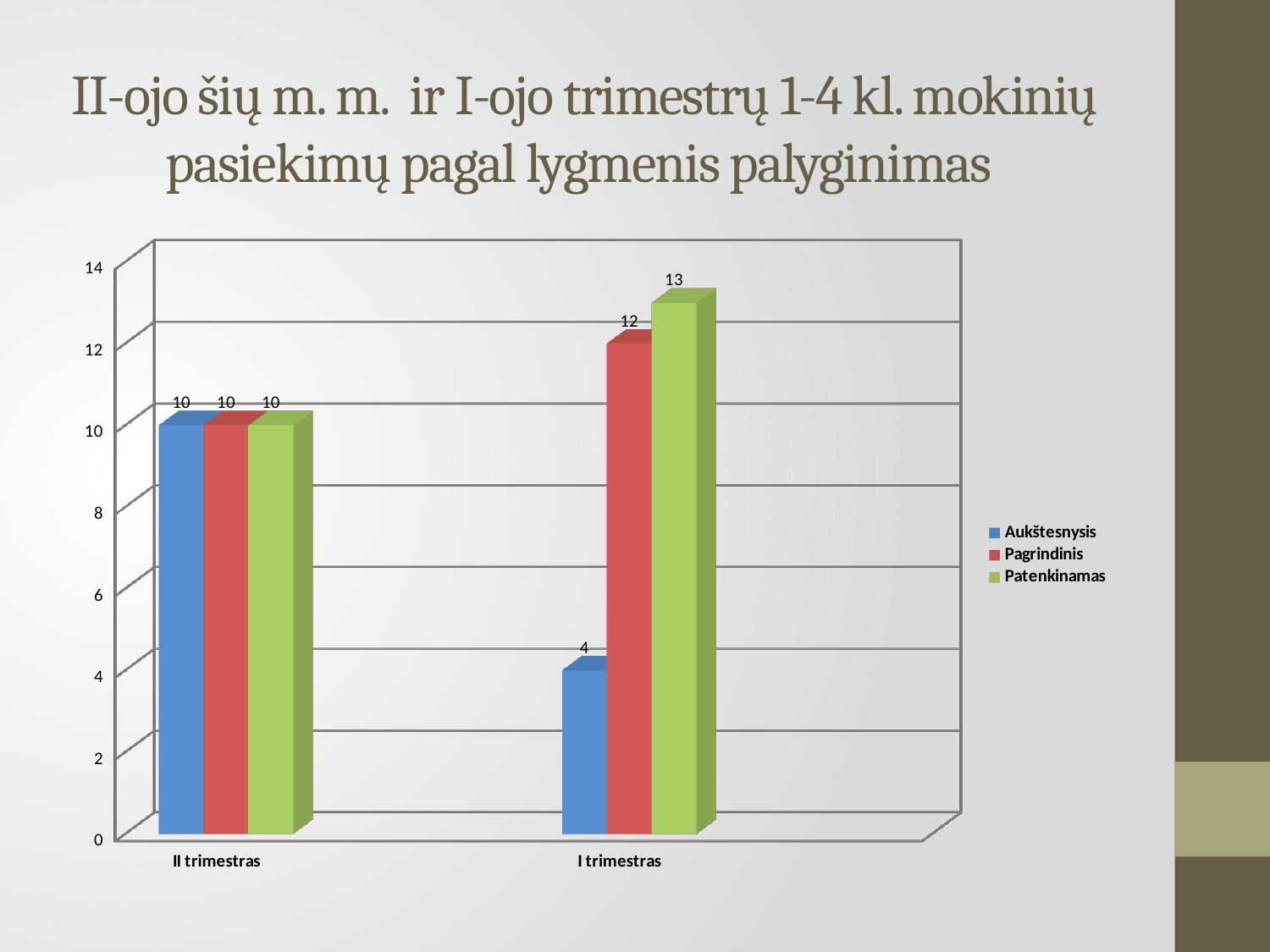
What is the value for Pagrindinis in I trimestras? 12 What kind of chart is shown on the slide? bar chart What is the value for Aukštesnysis in II trimestras? 10 Which colour represents Pagrindinis in the legend? red What is the value for Aukštesnysis in I trimestras? 4 What is the difference between the Patenkinamas value and the Aukštesnysis value in I trimestras? 9 Which series has the highest value in I trimestras? Patenkinamas What is the value for Patenkinamas in I trimestras? 13 How many categories are shown on the x axis? 2 How many series does the legend list? 3 Which is larger: the Pagrindinis value in I trimestras or the Pagrindinis value in II trimestras? I trimestras Which series has the lowest value in I trimestras? Aukštesnysis